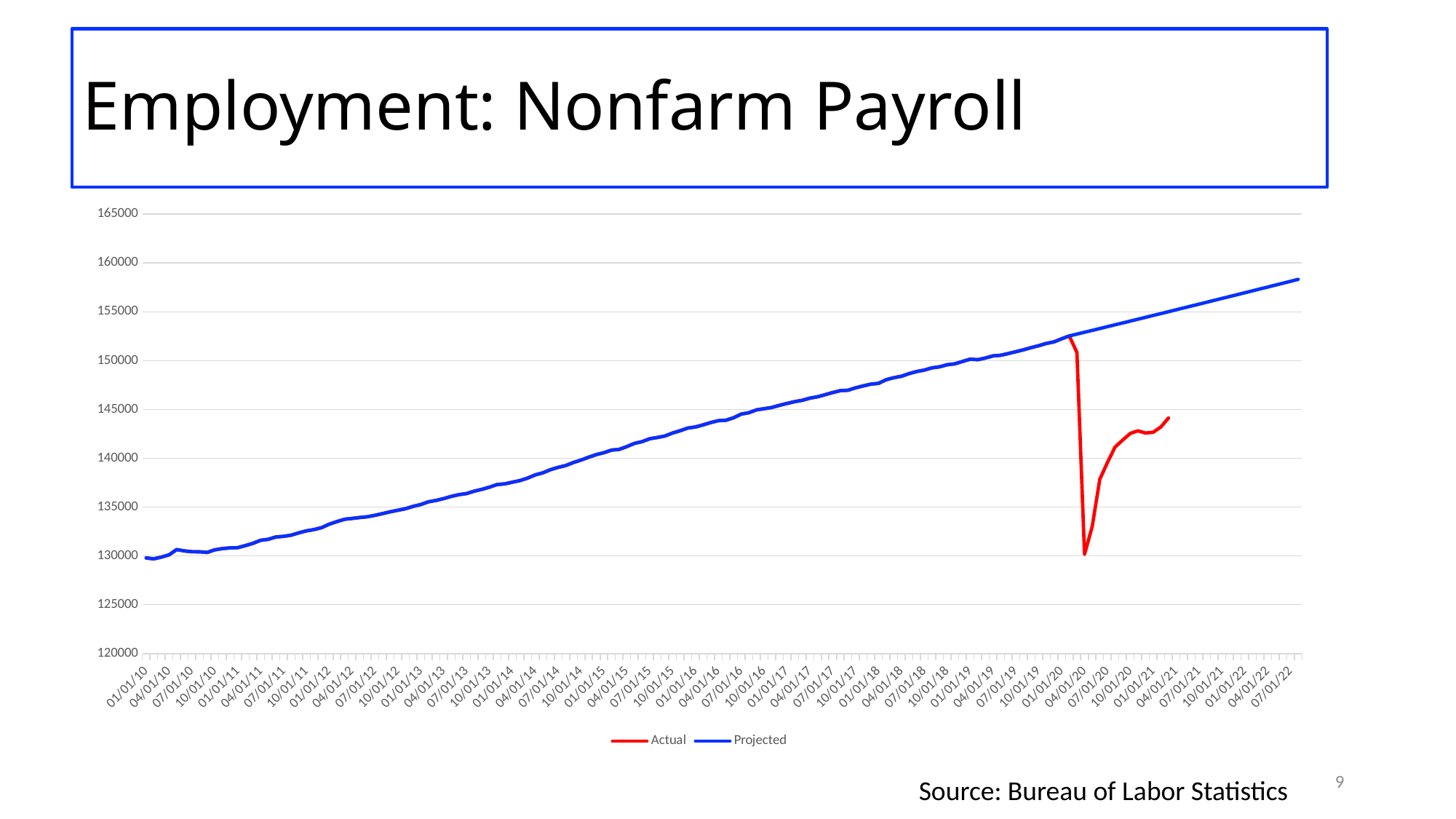
Which colour is used for the Projected series? blue Is the Projected value at 01/01/16 greater or less than 140000? greater Does the Actual series rise or fall between 01/01/20 and 04/01/20? fall What kind of chart is shown on the slide? line chart Around 04/01/21, which series has the higher value, Actual or Projected? Projected Does the Projected series rise or fall from 01/01/10 to 07/01/22? rise Is the Projected value at 01/01/10 greater or less than 135000? less How many series does the legend list? 2 Is the Projected value at 07/01/22 greater or less than 155000? greater What are the two series named in the legend? Actual and Projected